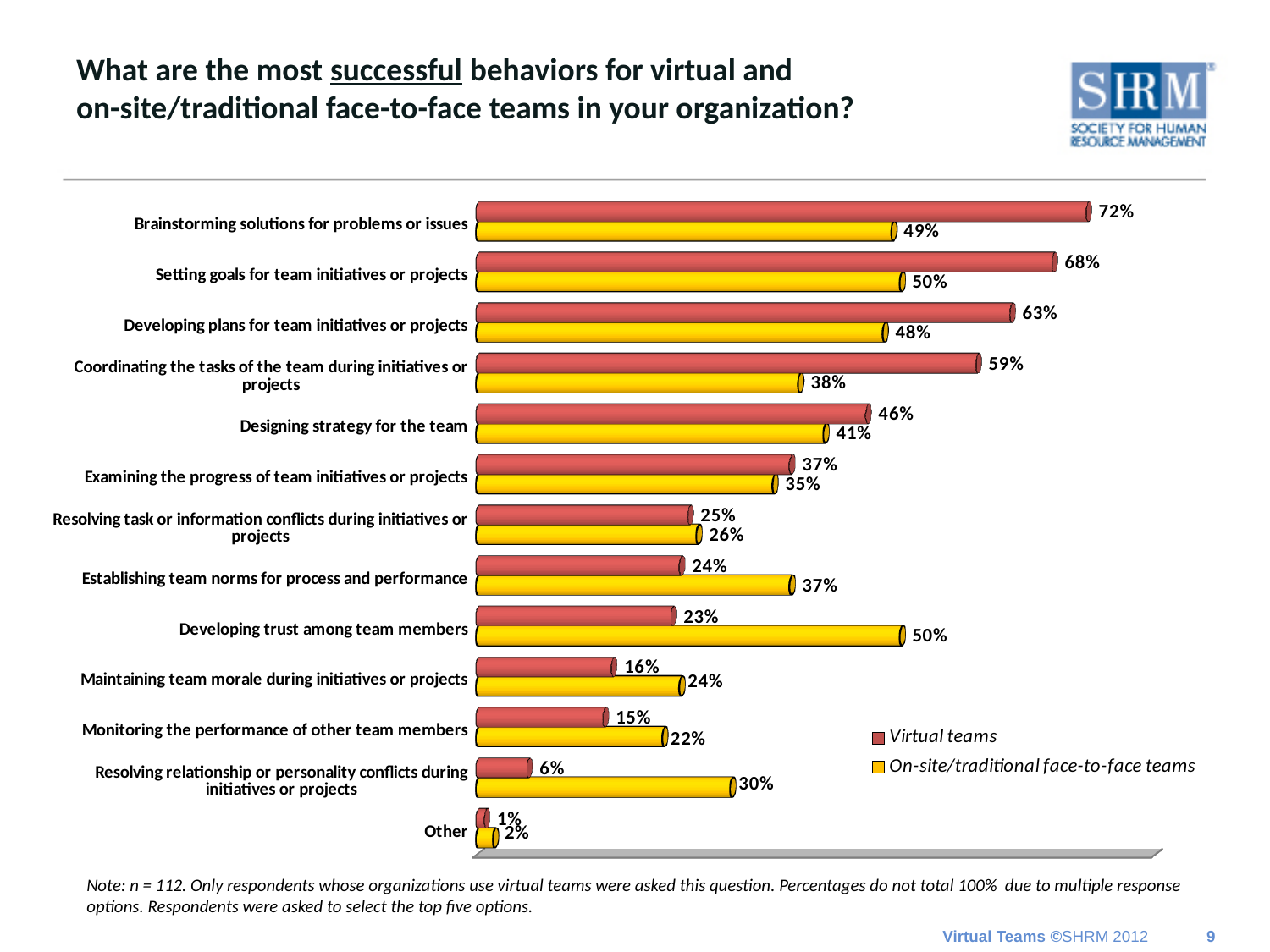
What is the difference between the two series for 'Resolving relationship or personality conflicts during initiatives or projects'? 24 percentage points How many series does the legend list? 2 What kind of chart is shown on the slide? Bar chart For 'Establishing team norms for process and performance', which series has the larger value? On-site/traditional face-to-face teams Which category has the lowest value for on-site/traditional face-to-face teams? Other What colour represents the 'Virtual teams' series? Red What is the value for 'Resolving relationship or personality conflicts during initiatives or projects' for virtual teams? 6% Which category has the highest value for virtual teams? Brainstorming solutions for problems or issues What percentage of respondents selected 'Brainstorming solutions for problems or issues' for virtual teams? 72% What is the difference between the virtual teams and on-site/traditional face-to-face teams values for 'Coordinating the tasks of the team during initiatives or projects'? 21 percentage points What is the value for 'Developing trust among team members' for on-site/traditional face-to-face teams? 50% How many categories are shown on the chart? 13